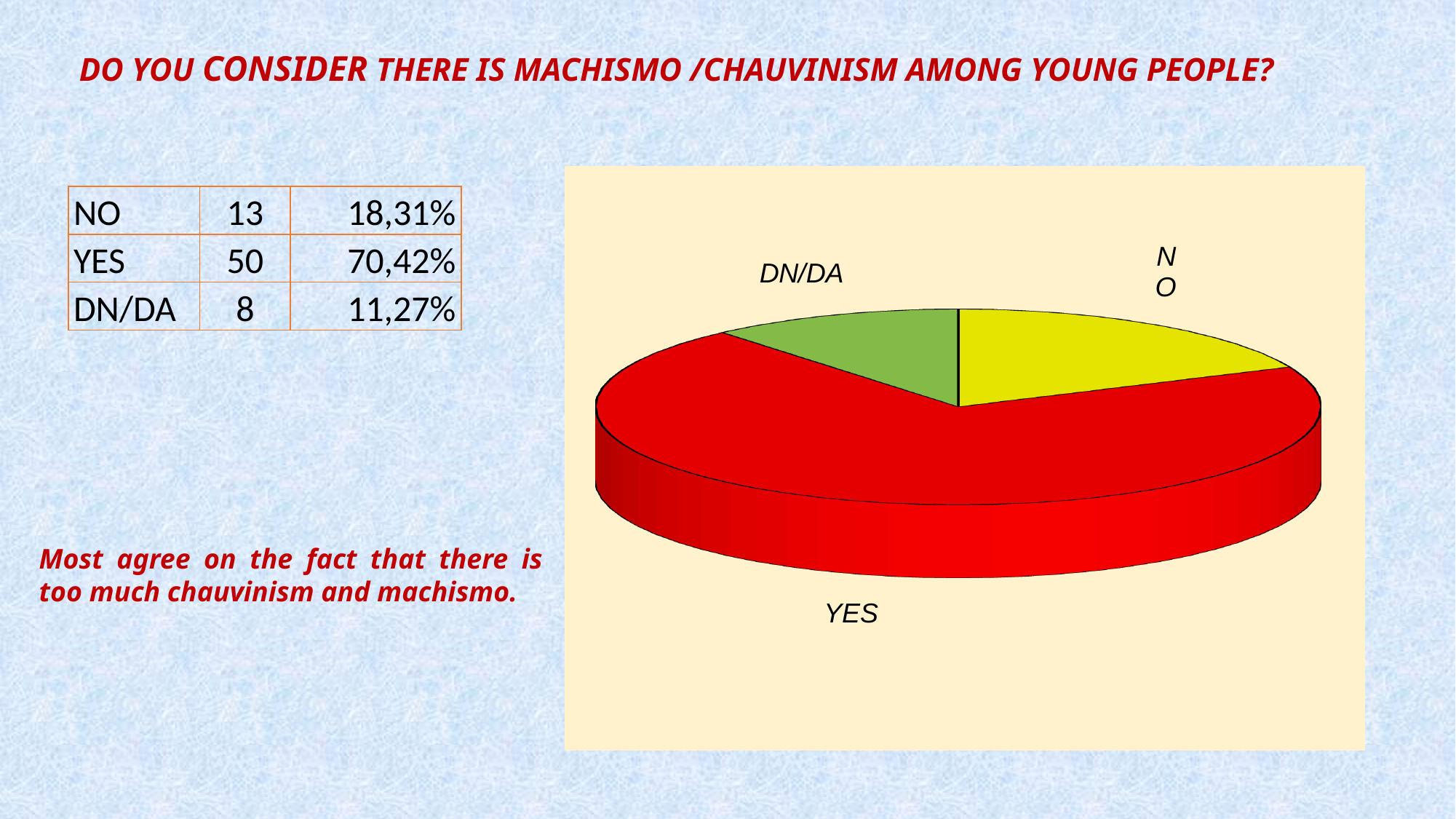
Which slice of the pie chart is the smallest? DN/DA Using the counts in the table, what is the difference between the number of YES and NO responses? 37 What colour is the YES slice of the pie chart? red According to the table on the slide, how many respondents answered YES? 50 How many slices does the pie chart have? 3 Which slice of the pie chart is the largest? YES Which slice is larger, NO or DN/DA? NO What kind of chart is shown on the slide? pie chart According to the table on the slide, what percentage share does the DN/DA slice represent? 11,27% According to the table on the slide, how many respondents answered DN/DA? 8 According to the table on the slide, what percentage share does the YES slice represent? 70,42% According to the table on the slide, what percentage share does the NO slice represent? 18,31%